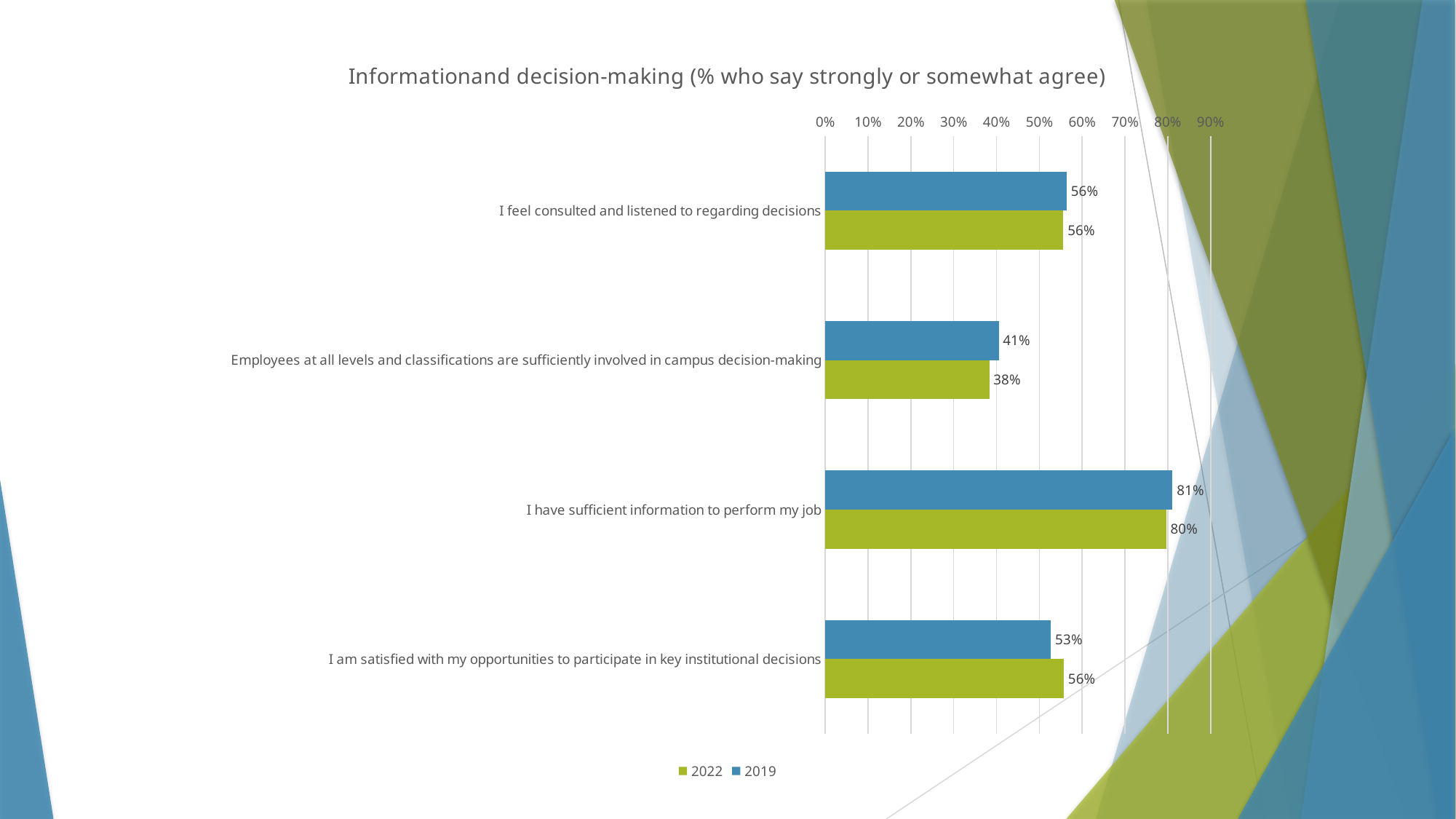
What is the difference between the 2019 and 2022 values for "Employees at all levels and classifications are sufficiently involved in campus decision-making"? 3% For "I am satisfied with my opportunities to participate in key institutional decisions", which year has the larger value, 2019 or 2022? 2022 What is the 2019 value for "Employees at all levels and classifications are sufficiently involved in campus decision-making"? 41% What is the 2019 value for "I feel consulted and listened to regarding decisions"? 56% Which category has the highest 2022 value? I have sufficient information to perform my job How many categories are shown on the chart? 4 What is the 2022 value for "I have sufficient information to perform my job"? 80% What is the 2022 value for "I am satisfied with my opportunities to participate in key institutional decisions"? 56% How many series does the legend list? 2 What is the title of the chart? Informationand decision-making (% who say strongly or somewhat agree) What kind of chart is shown on the slide? Bar chart Which category has the lowest 2019 value? Employees at all levels and classifications are sufficiently involved in campus decision-making